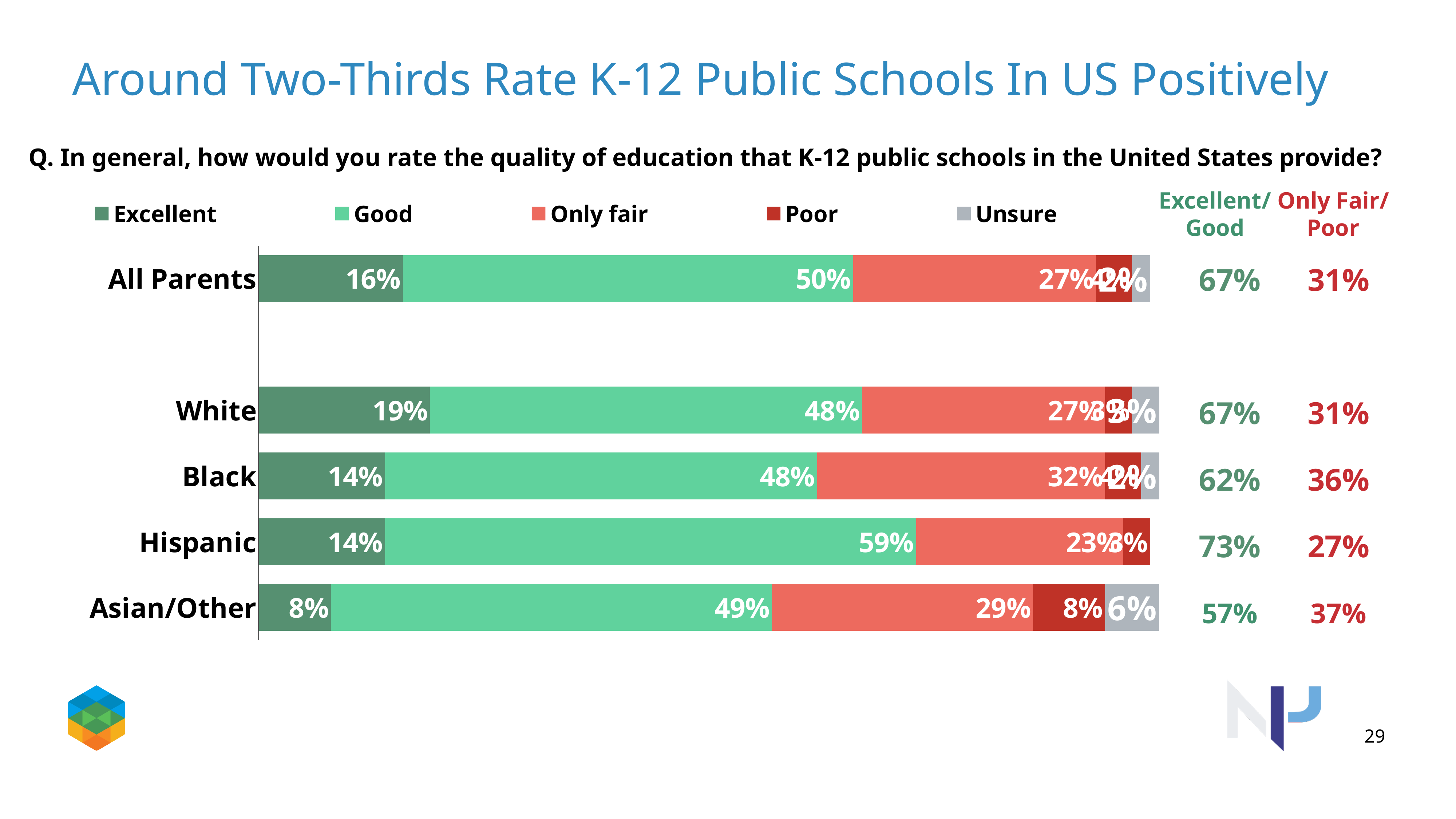
Which is larger, the Only fair value for Asian/Other or for White? Asian/Other What is the chart type? bar chart How many categories are shown on the chart? 5 What is the difference between the Good values for Hispanic and All Parents? 9% Which category has the lowest Excellent value? Asian/Other What is the Poor value for Asian/Other? 8% What is the Good value for Hispanic? 59% What is the Excellent value for White? 19% Which category has the highest Excellent value? White What is the Only fair value for Black? 32% What is the Excellent/Good combined value shown for Hispanic? 73% How many series does the legend list? 5